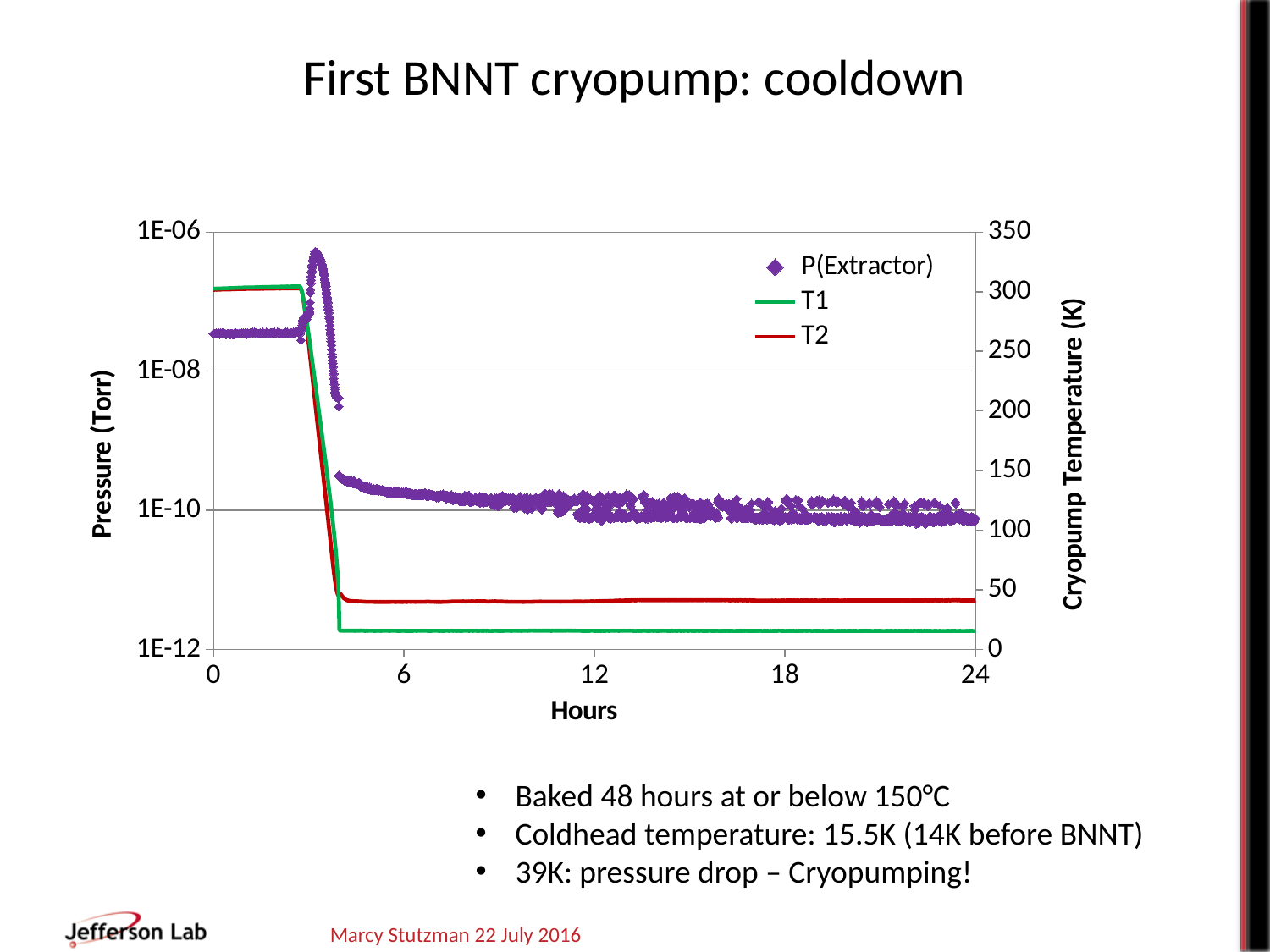
What is the label of the x axis of the chart? Hours Does the T1 series rise or fall overall from 0 to 24 hours? fall Is the value of T1 at 12 hours greater or less than 50? less Is the value of T1 at 0 hours greater or less than 250? greater Is the value of P(Extractor) at 12 hours greater or less than 1E-08? less How many series does the chart legend list? 3 At 12 hours, which is larger, T1 or T2? T2 What is the label of the right-hand y axis of the chart? Cryopump Temperature (K) What kind of chart is shown on the slide? line chart Which series is plotted with purple diamond markers? P(Extractor)